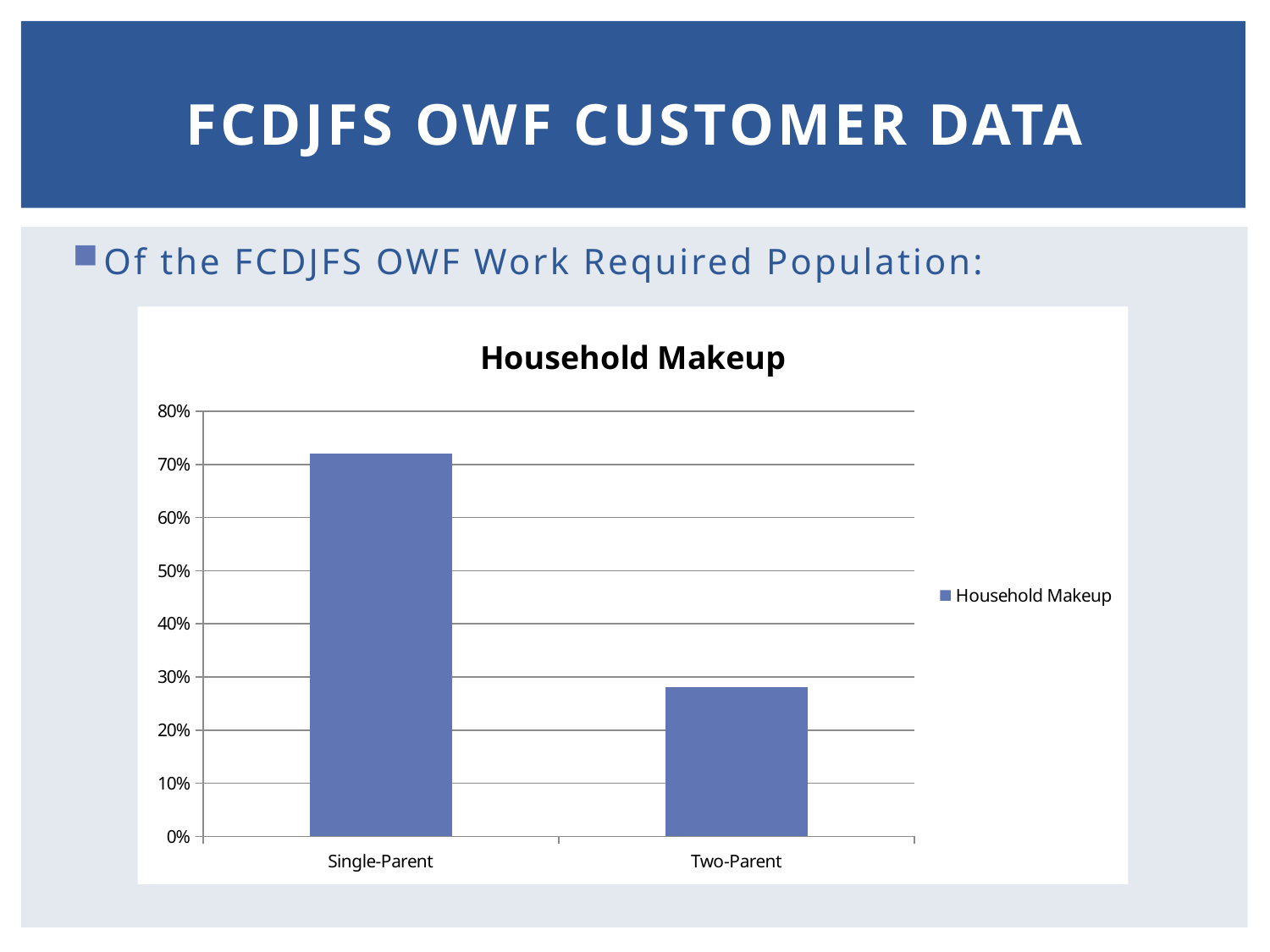
What is the name of the series listed in the legend? Household Makeup What is the title of the chart? Household Makeup Is the value for Two-Parent greater or less than 40%? less What kind of chart is shown on the slide? bar chart Which is larger, the value for Single-Parent or the value for Two-Parent? Single-Parent Is the value for Two-Parent greater or less than 20%? greater Is the value for Single-Parent greater or less than 60%? greater How many categories are shown on the x axis of the chart? 2 Which category has the highest value in the chart? Single-Parent How many series does the legend list? 1 Which category has the lowest value in the chart? Two-Parent